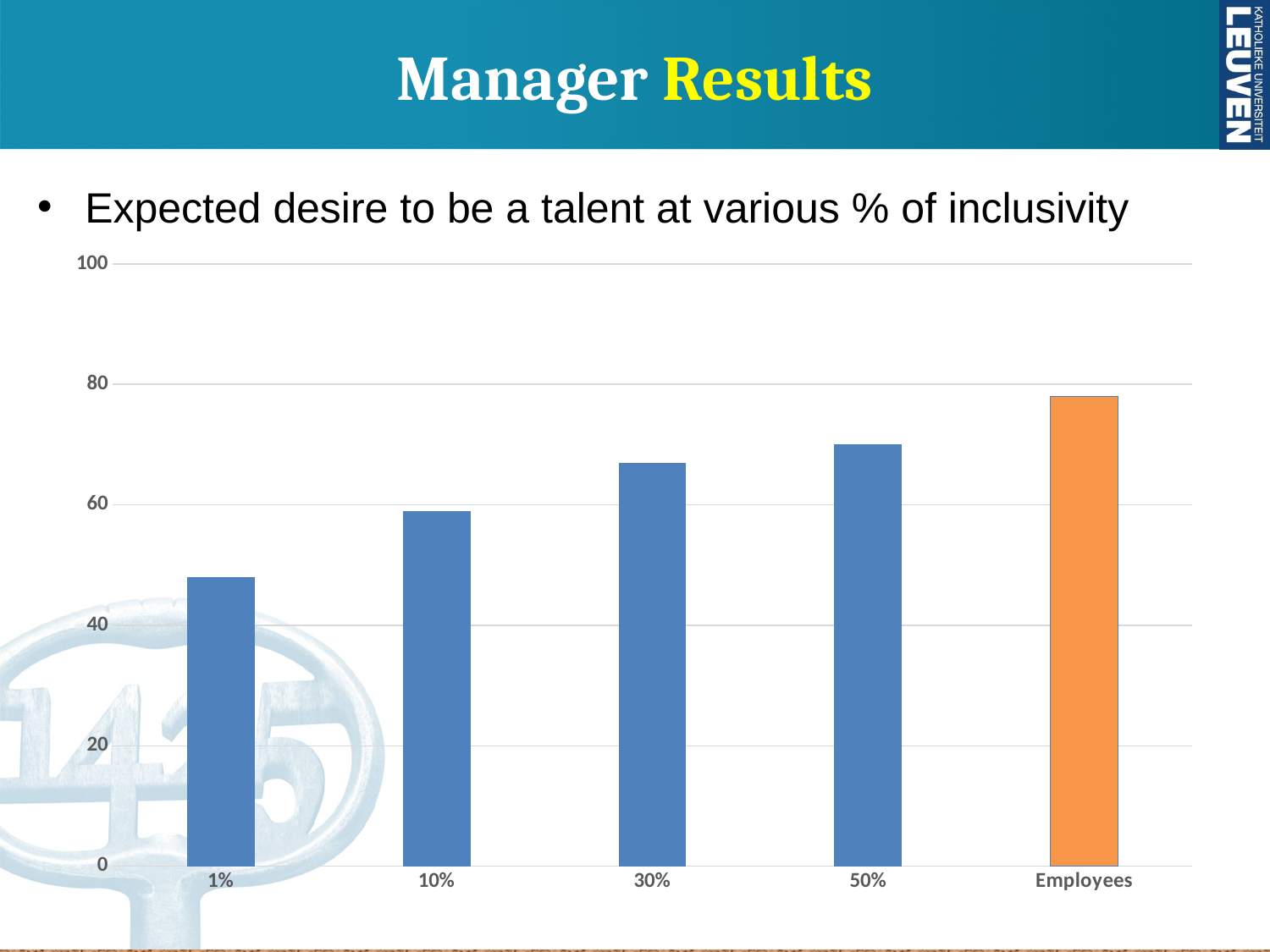
Is the value for 10% greater or less than 40? greater How many categories are shown on the x axis of the chart? 5 Which is larger, the value for 1% or the value for 30%? 30% Which category has the lowest bar in the chart? 1% Is the value for 30% greater or less than 60? greater Do the values rise or fall moving from 1% to Employees along the x axis? rise What kind of chart is shown on the slide? bar chart What colour is the bar for Employees? orange Is the value for 1% greater or less than 40? greater Which category has the highest bar in the chart? Employees